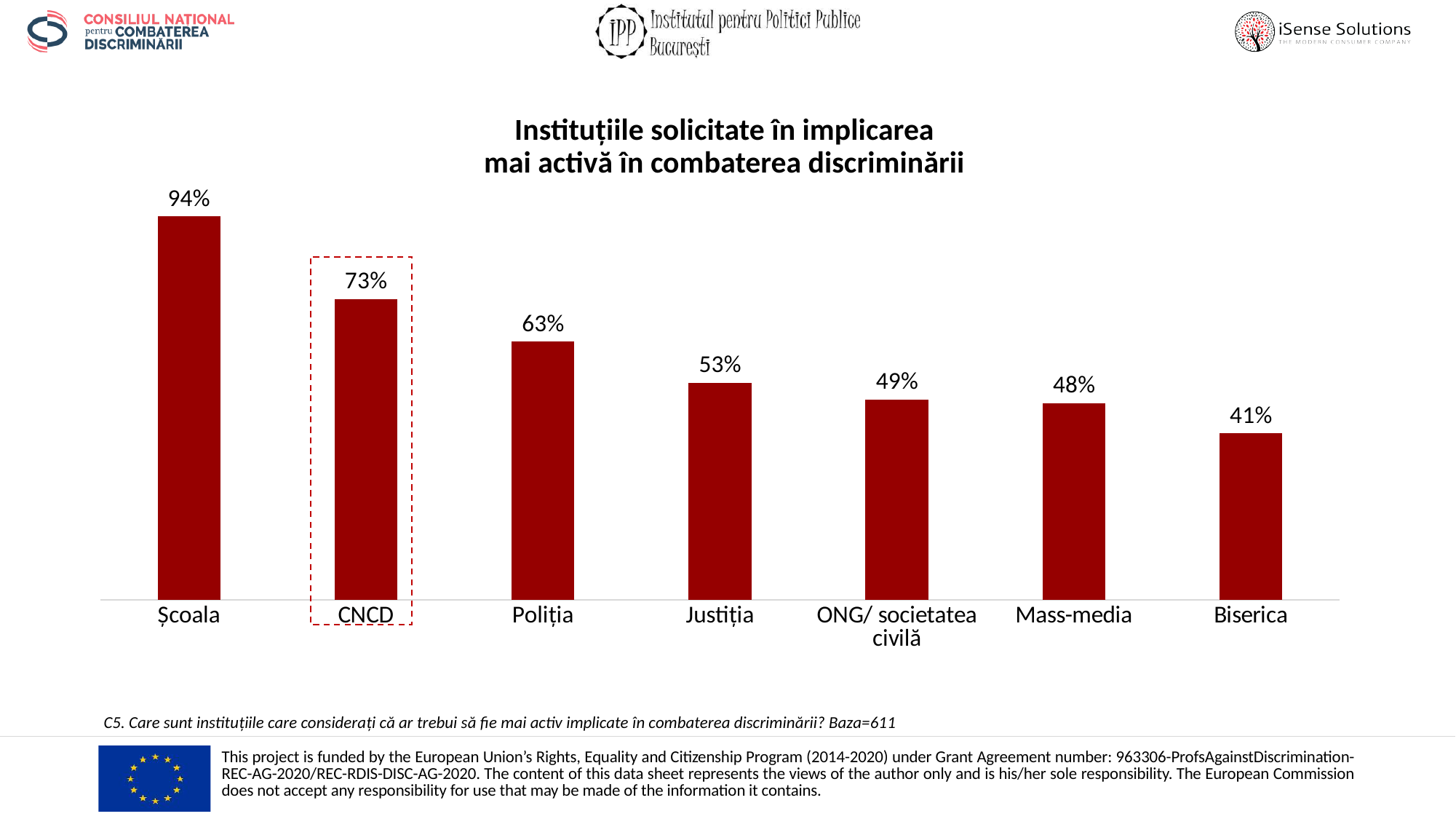
What kind of chart is shown on the slide? Bar chart Which category has the lowest value? Biserica What is the value for Biserica? 41% Which category is highlighted with a dashed red outline? CNCD What is the difference between the values for Școala and CNCD? 21% What is the value for Justiția? 53% What is the value for Școala? 94% Which is larger, the value for Poliția or the value for Mass-media? Poliția Which category has the highest value? Școala How many categories are shown in the chart? 7 What is the difference between the values for Poliția and Biserica? 22% What is the value for CNCD? 73%